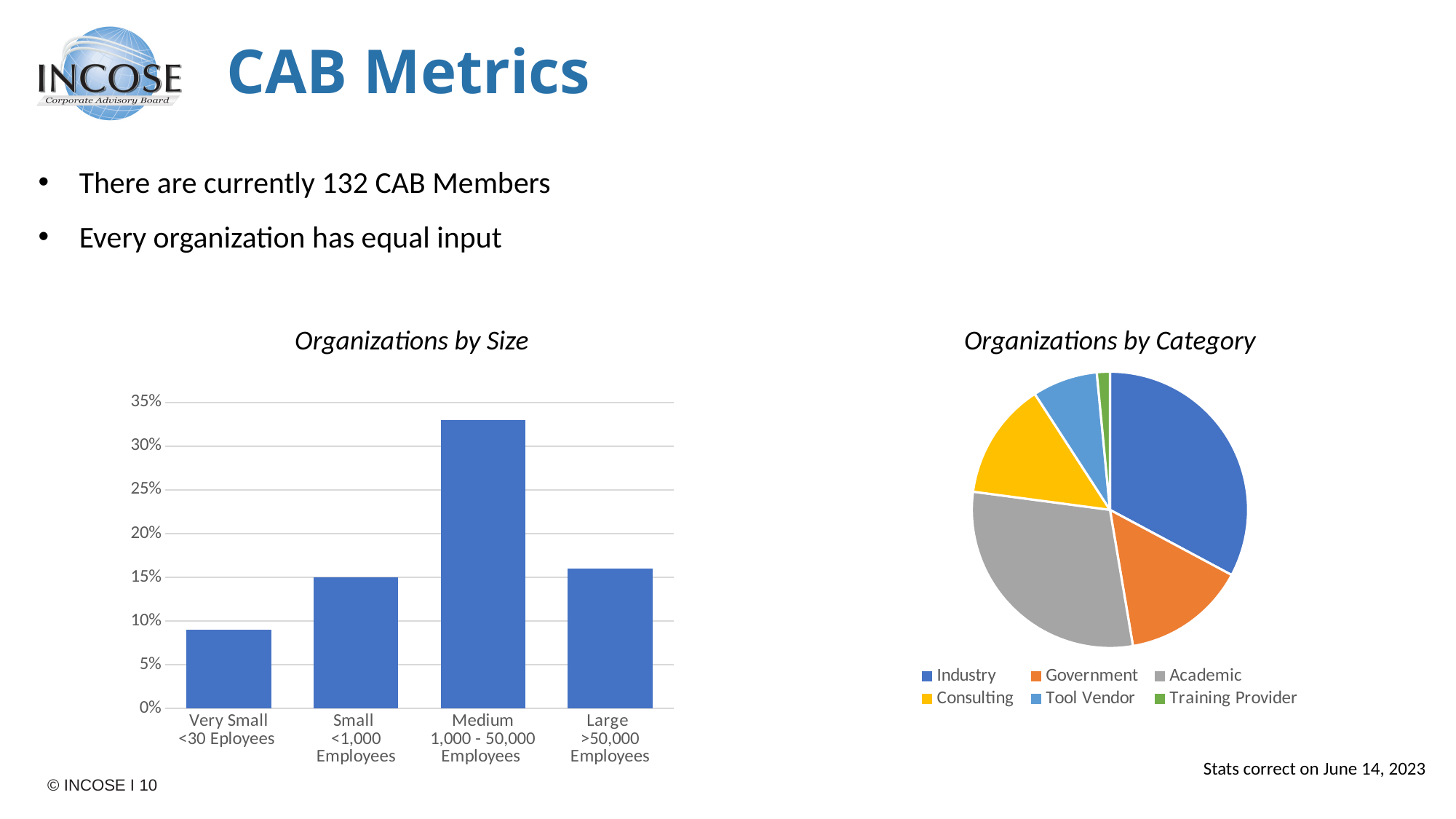
In the 'Organizations by Category' chart, which category has the largest slice? Industry In the 'Organizations by Size' chart, is the value for Medium greater or less than 30%? greater In the 'Organizations by Size' chart, which size category has the lowest value? Very Small In the 'Organizations by Size' chart, is the value for Large greater or less than 20%? less In the 'Organizations by Size' chart, how many size categories are shown? 4 What kind of chart is the 'Organizations by Size' chart? bar chart In the 'Organizations by Category' chart, how many categories does the legend list? 6 In the 'Organizations by Size' chart, which is larger, the value for Medium or the value for Large? Medium What kind of chart is the 'Organizations by Category' chart? pie chart In the 'Organizations by Size' chart, is the value for Very Small greater or less than 10%? less In the 'Organizations by Category' chart, which category has the smallest slice? Training Provider In the 'Organizations by Size' chart, which size category has the highest value? Medium